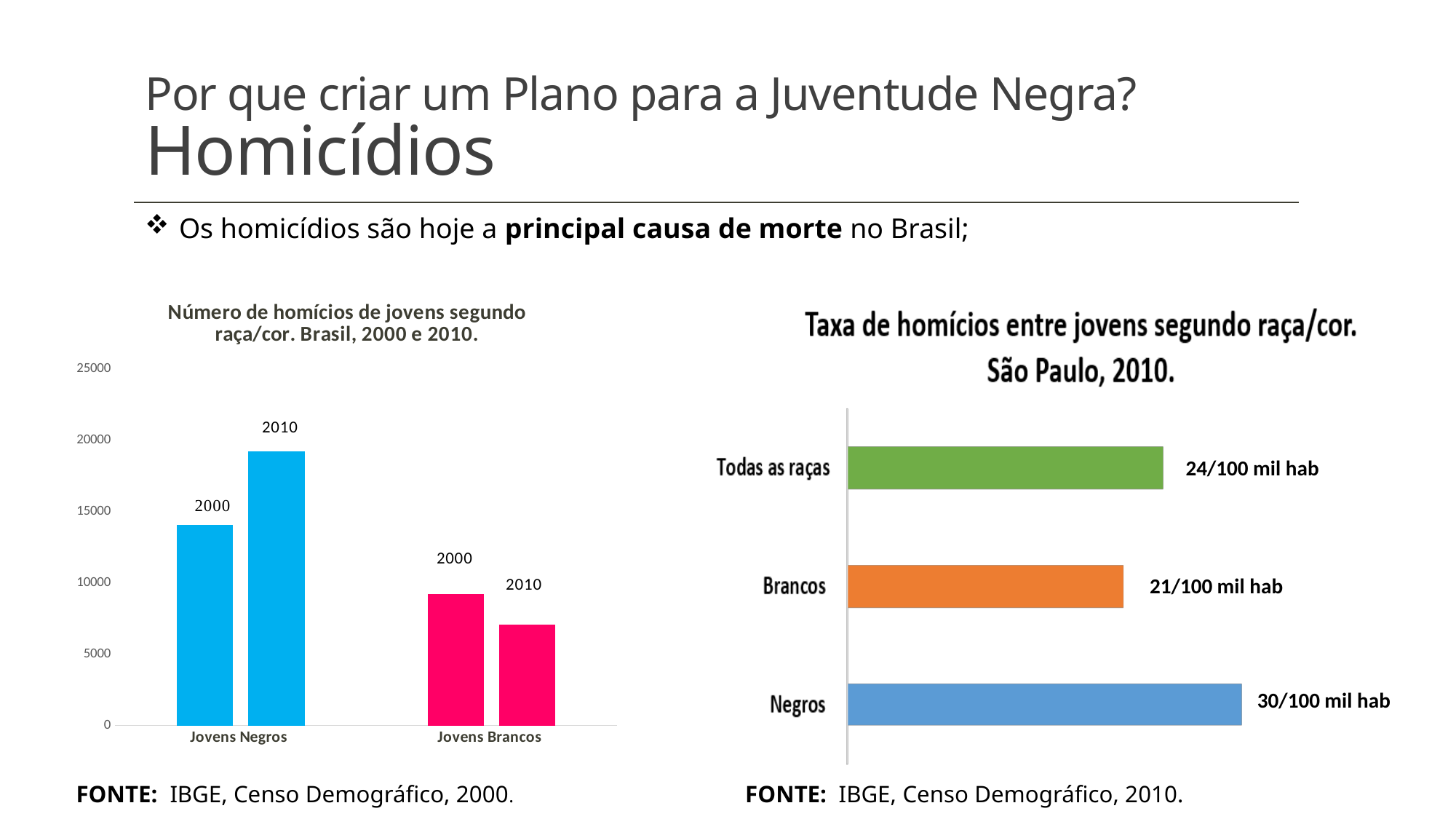
In the right chart 'Taxa de homícios entre jovens segundo raça/cor. São Paulo, 2010.', what is the difference between the rate for Negros and the rate for Brancos (per 100 mil hab)? 9 In the right chart 'Taxa de homícios entre jovens segundo raça/cor. São Paulo, 2010.', what is the value for Brancos? 21/100 mil hab In the left chart 'Número de homícios de jovens segundo raça/cor. Brasil, 2000 e 2010.', what colour are the bars for Jovens Brancos? pink In the left chart 'Número de homícios de jovens segundo raça/cor. Brasil, 2000 e 2010.', is the value for Jovens Brancos in 2010 greater or less than 10000? less In the right chart 'Taxa de homícios entre jovens segundo raça/cor. São Paulo, 2010.', how many categories are shown? 3 What kind of chart is the left chart 'Número de homícios de jovens segundo raça/cor. Brasil, 2000 e 2010.'? bar chart In the left chart 'Número de homícios de jovens segundo raça/cor. Brasil, 2000 e 2010.', which is larger: Jovens Negros in 2000 or Jovens Brancos in 2000? Jovens Negros in 2000 In the right chart 'Taxa de homícios entre jovens segundo raça/cor. São Paulo, 2010.', which category has the highest rate? Negros In the right chart 'Taxa de homícios entre jovens segundo raça/cor. São Paulo, 2010.', what is the value for Todas as raças? 24/100 mil hab In the left chart 'Número de homícios de jovens segundo raça/cor. Brasil, 2000 e 2010.', is the value for Jovens Negros in 2010 greater or less than 15000? greater In the right chart 'Taxa de homícios entre jovens segundo raça/cor. São Paulo, 2010.', what is the value for Negros? 30/100 mil hab In the right chart 'Taxa de homícios entre jovens segundo raça/cor. São Paulo, 2010.', which category has the lowest rate? Brancos